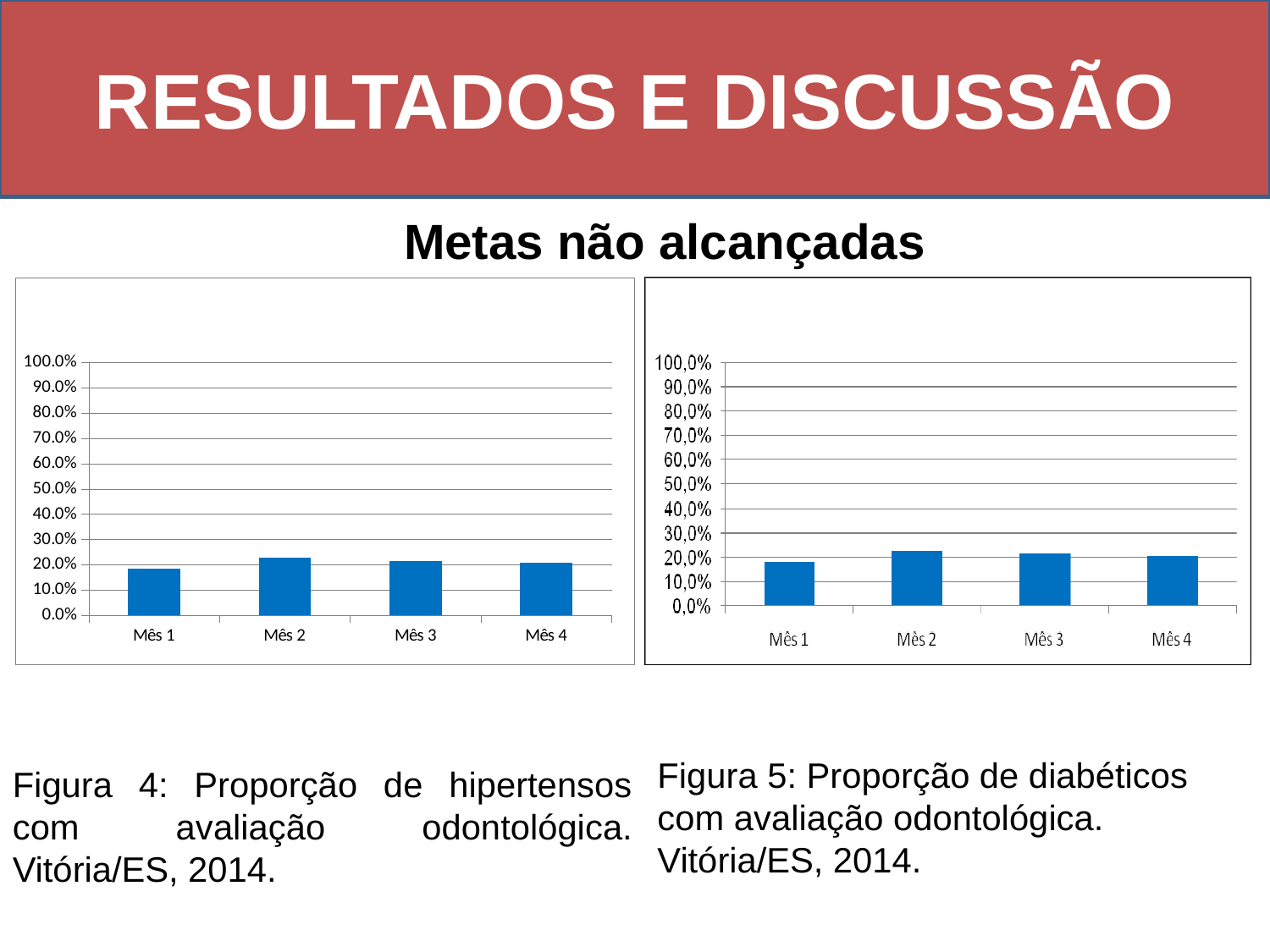
In the right chart (Figura 5), is the value for Mês 1 greater or less than 10,0%? greater How many categories (months) are shown on the x axis of the right chart (Figura 5)? 4 In the left chart (Figura 4), is the value for Mês 1 greater or less than 20.0%? less In the left chart (Figura 4), is the value for Mês 2 greater or less than 20.0%? greater What kind of chart is the left chart (Figura 4)? bar chart In the left chart (Figura 4), which month has the highest bar? Mês 2 In the right chart (Figura 5), which month has the highest bar? Mês 2 What is the heading shown above the two charts? Metas não alcançadas In the left chart (Figura 4), which month has the lowest bar? Mês 1 In the left chart (Figura 4), which is larger, the value for Mês 1 or the value for Mês 2? Mês 2 In the right chart (Figura 5), which month has the lowest bar? Mês 1